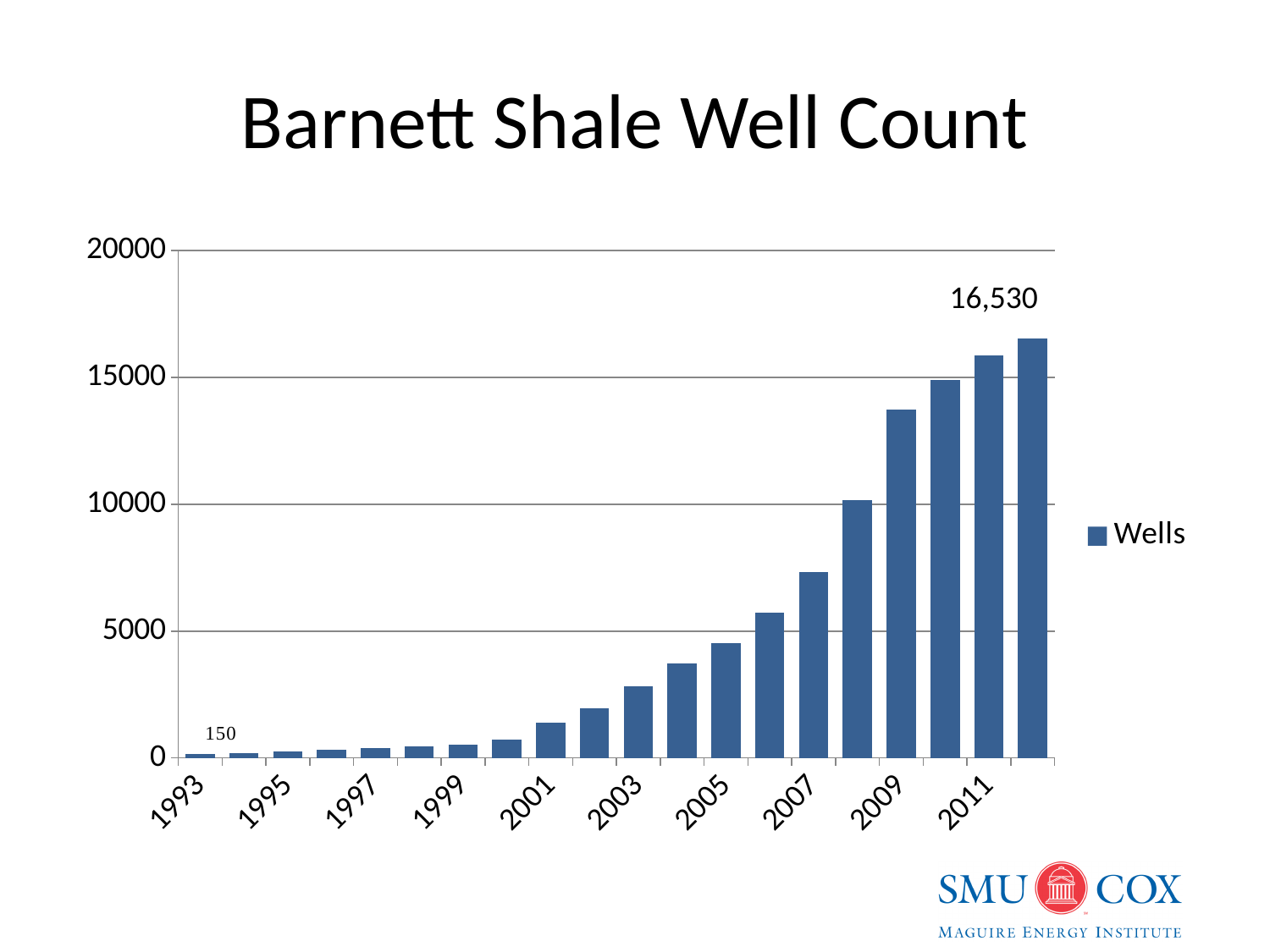
What value is labelled on the rightmost bar of the chart? 16,530 How many series does the legend list? 1 Is the well count for 2007 greater or less than 10000? less Is the well count for 2009 greater or less than 10000? greater What kind of chart is shown on the slide? bar chart Which year has the lowest well count? 1993 Which year has the larger well count, 2007 or 2009? 2009 What is the well count for 1993? 150 What is the difference between the labelled value on the rightmost bar (16,530) and the 1993 value (150)? 16,380 What is the title of the chart? Barnett Shale Well Count Do the well counts rise or fall from 1993 to the last year shown? rise Is the well count for 2003 greater or less than 5000? less